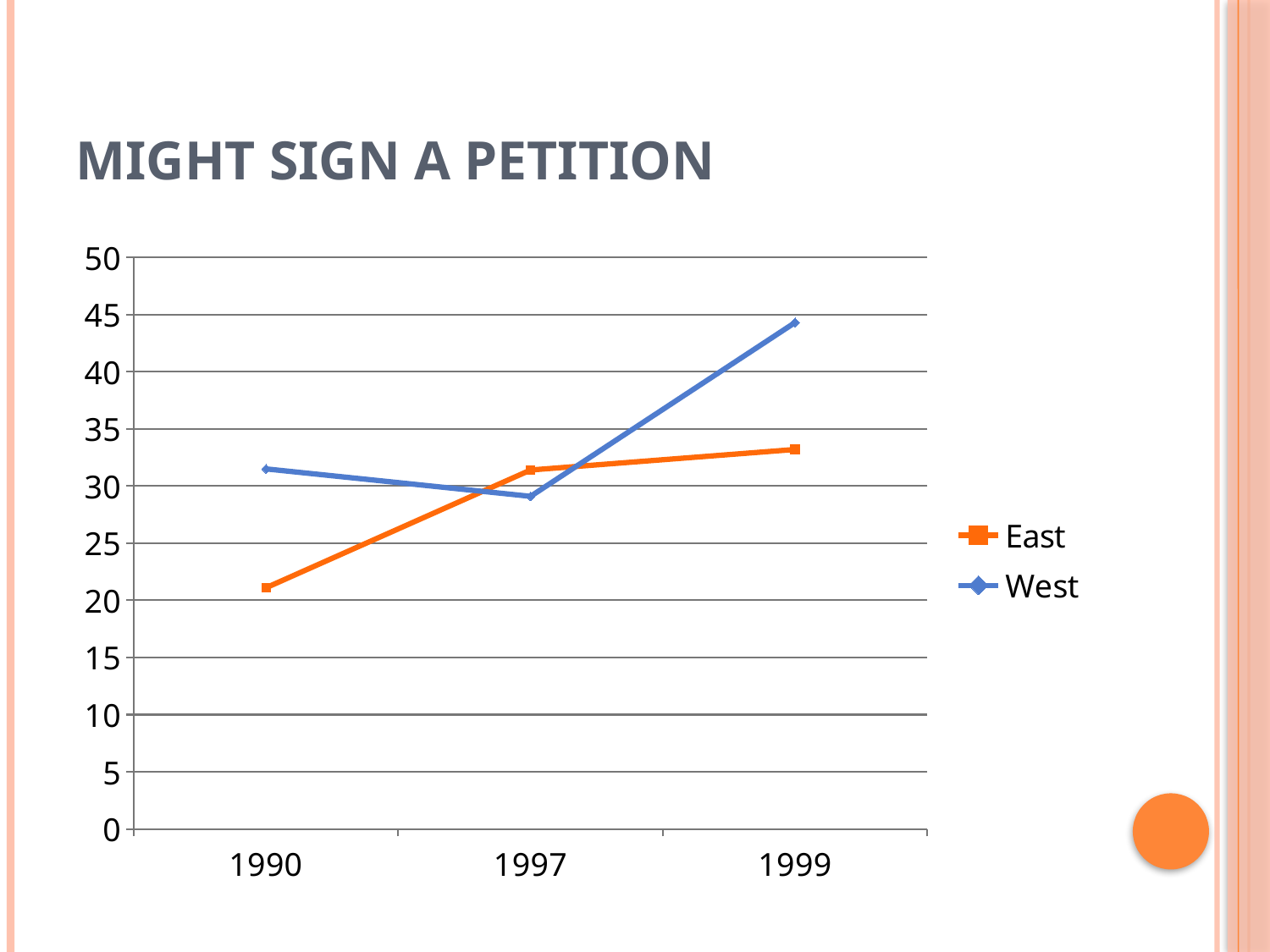
How many years are plotted along the x axis? 3 What is the title of the chart on the slide? MIGHT SIGN A PETITION In 1999, which series has the larger value, East or West? West In which year is the West series at its lowest? 1997 What kind of chart is shown on the slide? line chart Is the value for West in 1999 greater or less than 40? greater How many series does the legend list? 2 In which year is the West series at its highest? 1999 In 1990, which series has the larger value, East or West? West Is the value for East in 1990 greater or less than 25? less In which year is the East series at its lowest? 1990 Does the East series rise or fall from 1990 to 1999? rise